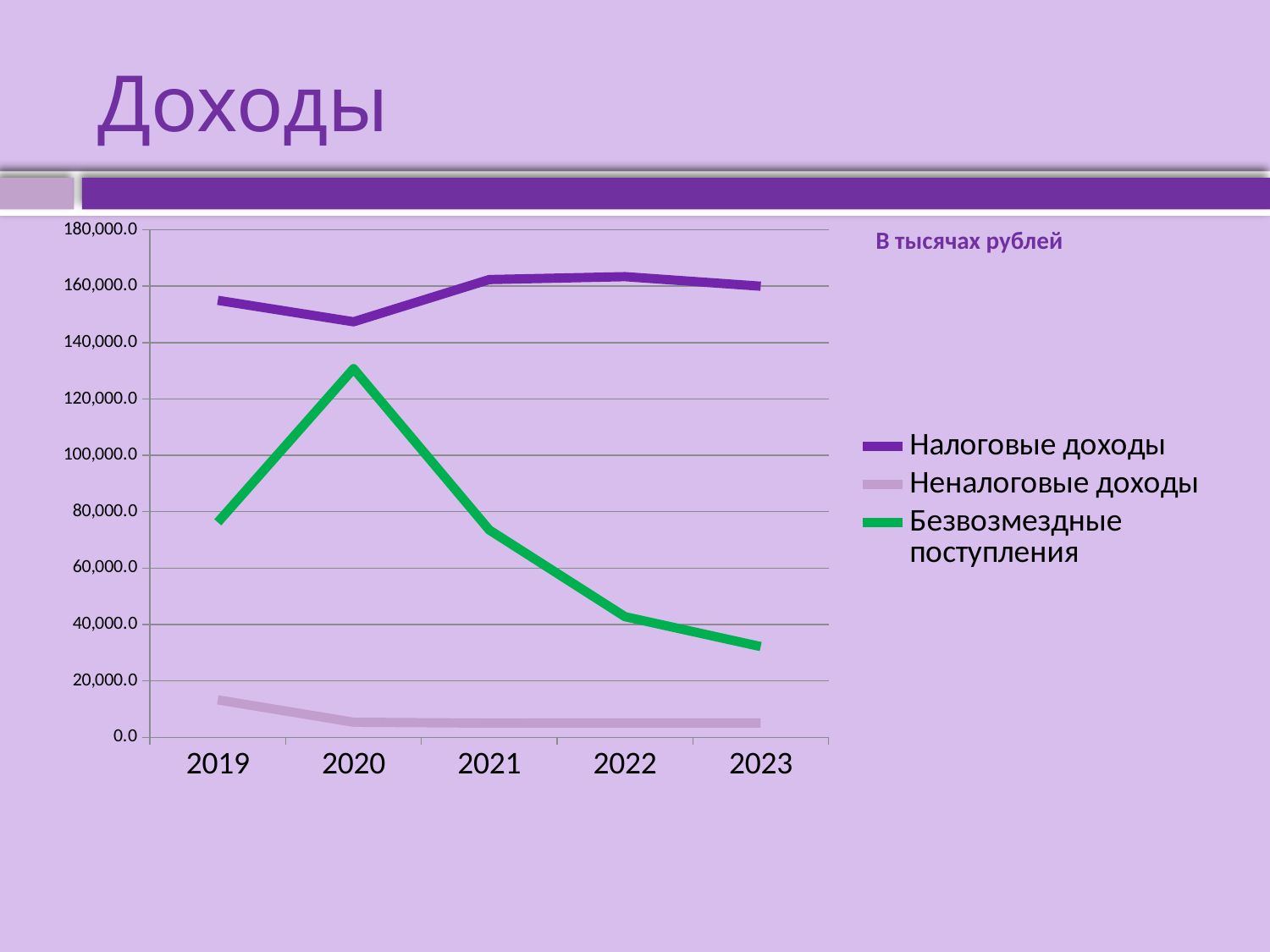
Is the value for Налоговые доходы in 2019 greater or less than 160,000.0? less Is the value for Безвозмездные поступления in 2020 greater or less than 120,000.0? greater How many series does the legend list? 3 In which year is Неналоговые доходы highest? 2019 What kind of chart is shown on the slide? line chart Which is larger in 2021, Налоговые доходы or Безвозмездные поступления? Налоговые доходы In which year is Налоговые доходы lowest? 2020 How many years are shown on the x axis? 5 In which year is Безвозмездные поступления highest? 2020 In which year is Безвозмездные поступления lowest? 2023 Do the values for Безвозмездные поступления rise or fall from 2020 to 2023? fall Is the value for Безвозмездные поступления in 2023 greater or less than 40,000.0? less